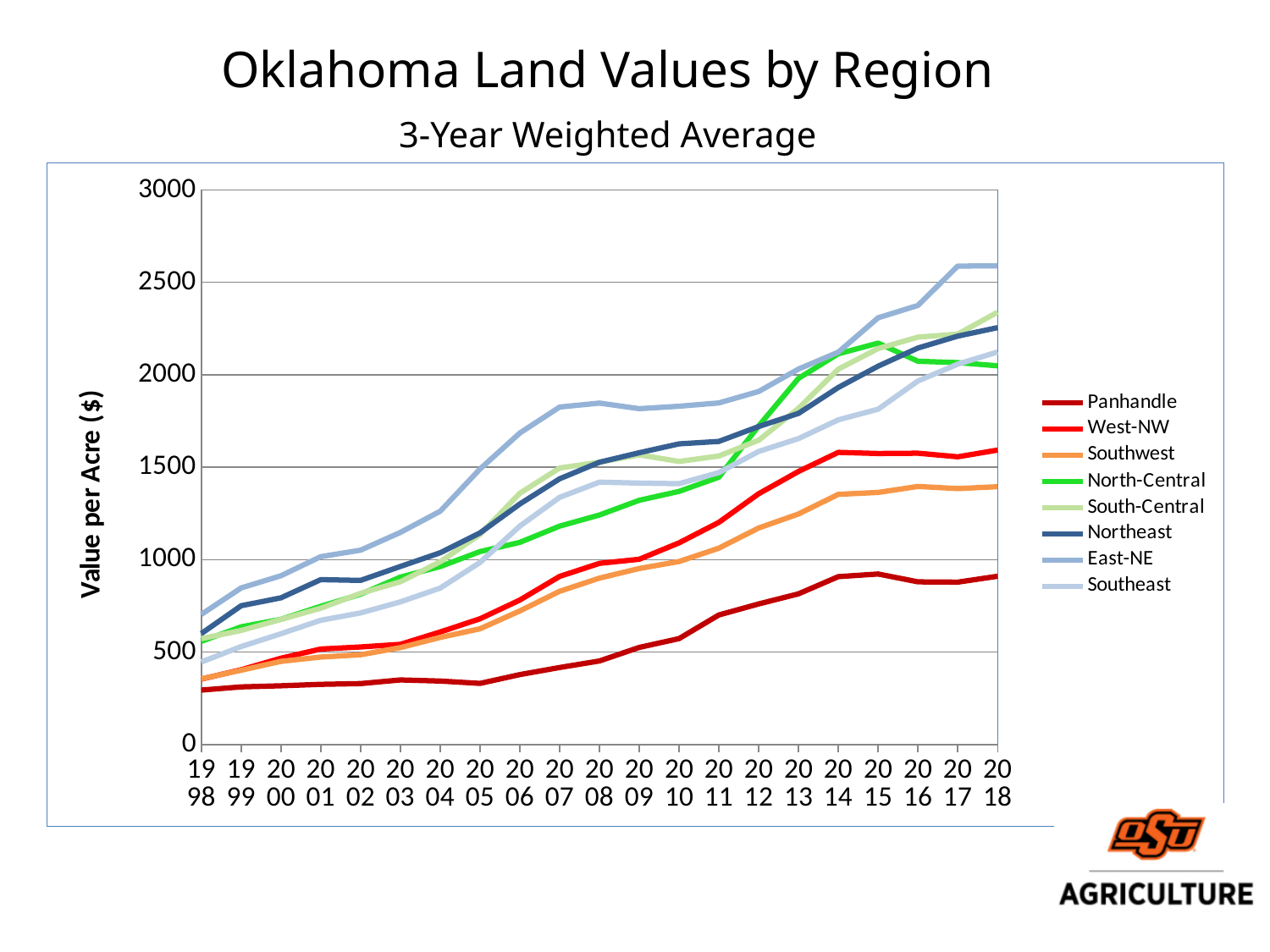
What is the label on the y axis of the chart? Value per Acre ($) What kind of chart is shown on the slide? line chart Do the Panhandle values generally rise or fall from 1998 to 2018? rise Which region has the highest value per acre in 2018? East-NE How many years are shown along the x axis? 21 Is the value for East-NE in 2018 greater or less than 2500? greater Which region has the lowest value per acre in 2018? Panhandle Is the value for Northeast in 2018 greater or less than 2000? greater Is the value for Panhandle in 2018 greater or less than 1000? less How many series does the legend list? 8 Which is larger in 2018, the value for West-NW or the value for Panhandle? West-NW